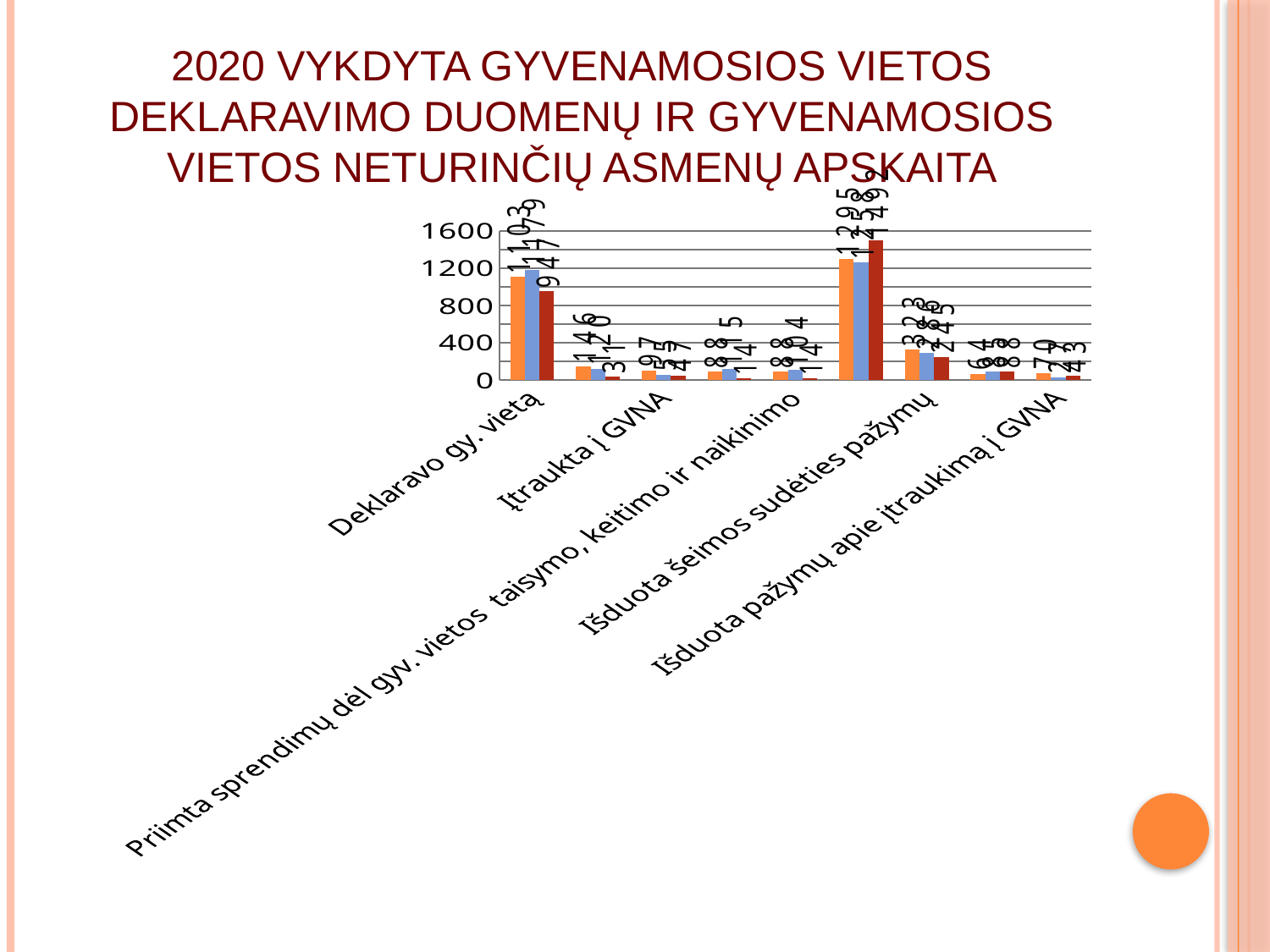
Which of the three bars for 'Deklaravo gy. vietą' is the highest: the first, second or third? the second What type of chart is shown on the slide? bar chart Is the value of the third (dark red) bar for 'Deklaravo gy. vietą' greater or less than 1200? less How many bars are plotted for each category in the chart? 3 What is the highest value shown on the vertical axis of the chart? 1600 Are all the bars for 'Išduota pažymų apie įtraukimą į GVNA' greater or less than 400? less Are all the bars for 'Įtraukta į GVNA' greater or less than 400? less For 'Deklaravo gy. vietą', is the first (orange) bar or the third (dark red) bar larger? the first (orange) bar Which of the three bars for 'Deklaravo gy. vietą' is the lowest: the first, second or third? the third What is the value of the first (orange) bar for 'Deklaravo gy. vietą'? 1103